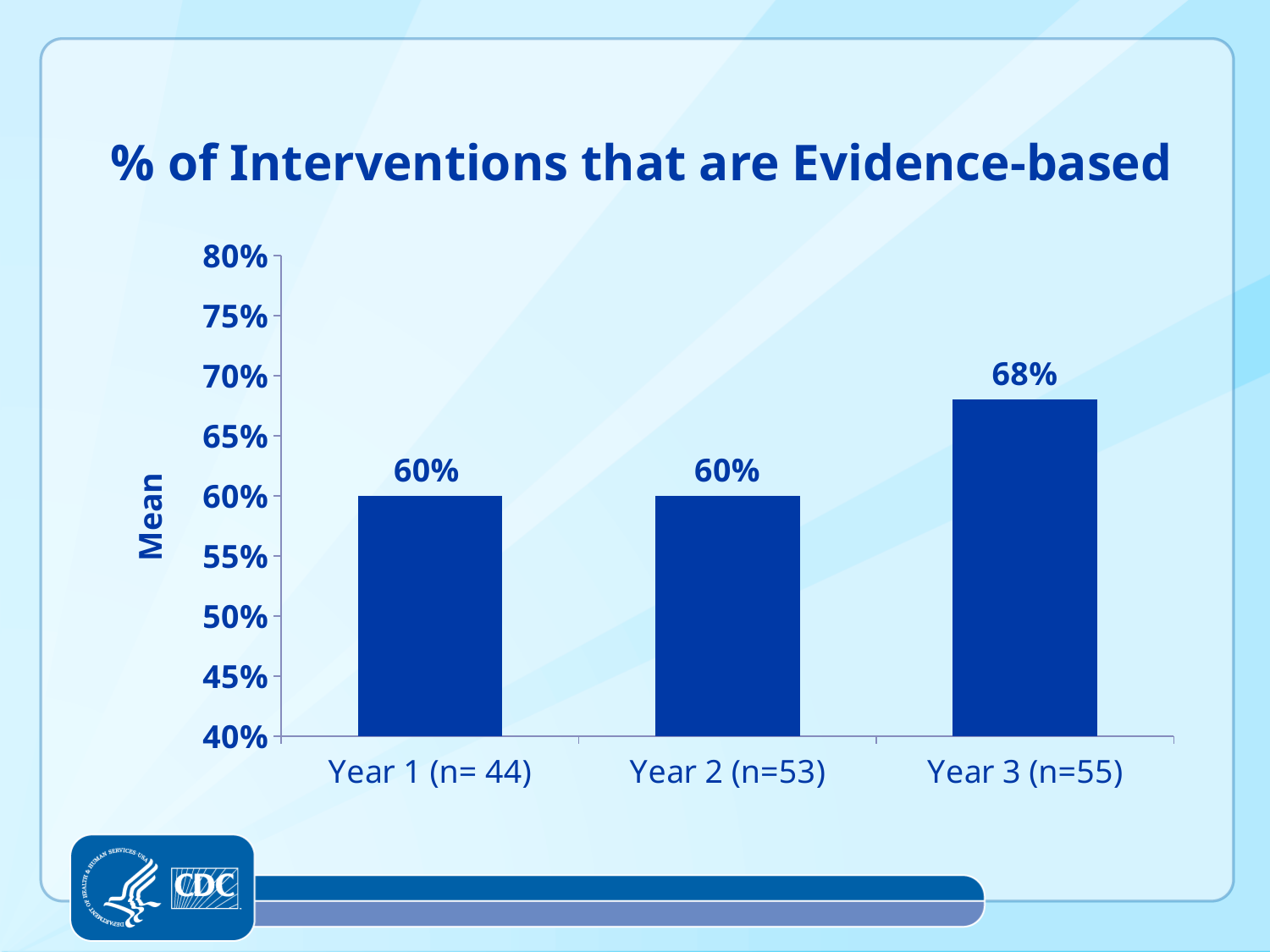
What is the value for Year 2 (n=53)? 60% What is the value for Year 1 (n= 44)? 60% Which category has the highest value? Year 3 (n=55) What kind of chart is shown on the slide? bar chart Which is larger, the value for Year 3 (n=55) or the value for Year 2 (n=53)? Year 3 (n=55) How many categories are shown on the x axis? 3 Is the value for Year 1 (n= 44) greater or less than 65%? less What is the difference between the values for Year 3 (n=55) and Year 1 (n= 44)? 8% What is the value for Year 3 (n=55)? 68% Do the values rise or fall from Year 2 (n=53) to Year 3 (n=55)? rise What is the title of the chart? % of Interventions that are Evidence-based Is the value for Year 3 (n=55) greater or less than 65%? greater